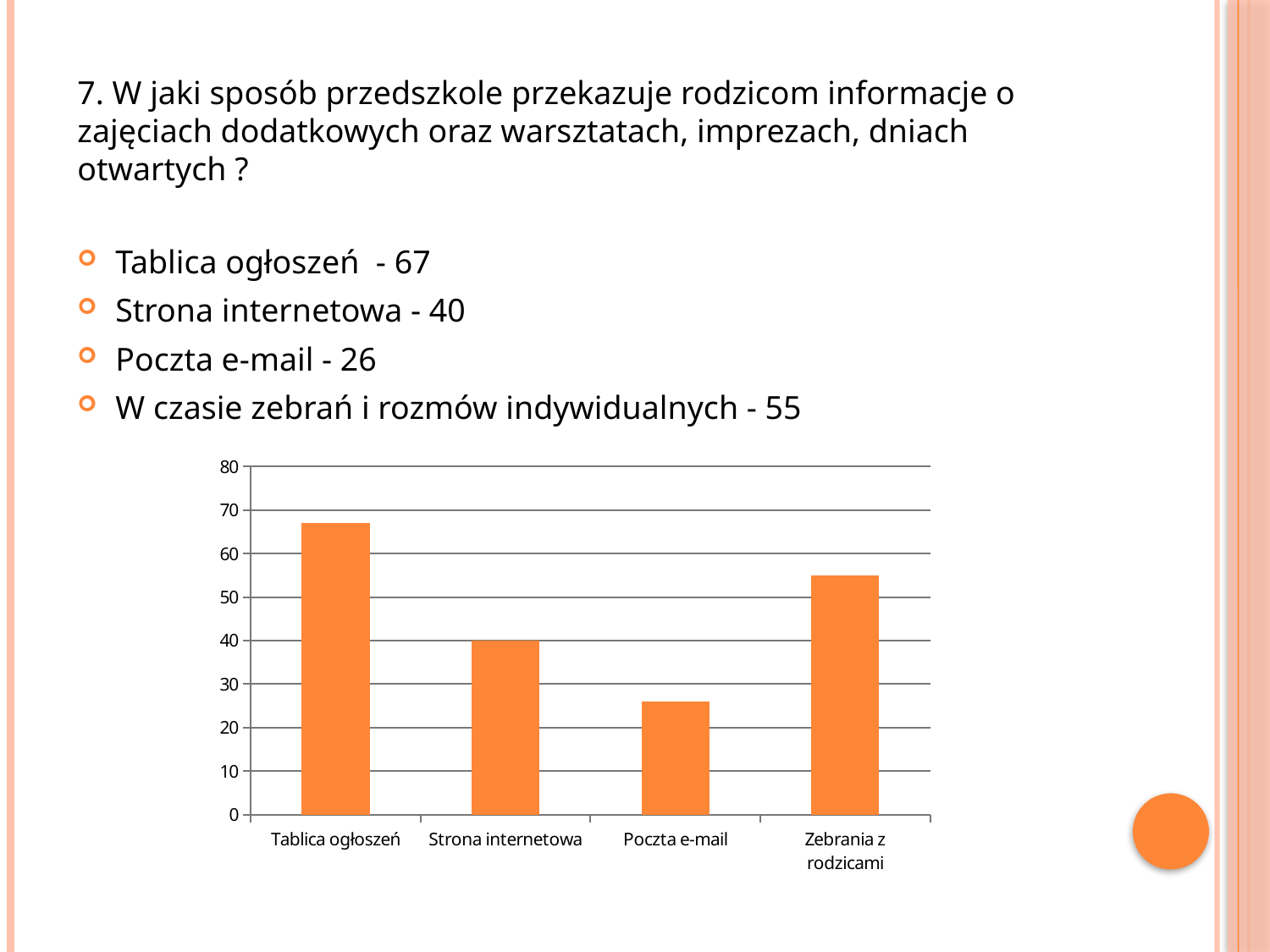
Which category has the highest bar in the chart? Tablica ogłoszeń Which category has the lowest bar in the chart? Poczta e-mail Is the value for Poczta e-mail greater or less than 30? less What is the value for Poczta e-mail in the chart? 26 What is the value for Strona internetowa in the chart? 40 Which is larger in the chart, Zebrania z rodzicami or Strona internetowa? Zebrania z rodzicami What is the value for Zebrania z rodzicami in the chart? 55 What is the value for Tablica ogłoszeń in the chart? 67 What is the highest value shown on the vertical axis of the chart? 80 What is the difference between the values for Tablica ogłoszeń and Poczta e-mail? 41 What type of chart is shown on the slide? bar chart How many categories are shown on the x axis of the chart? 4